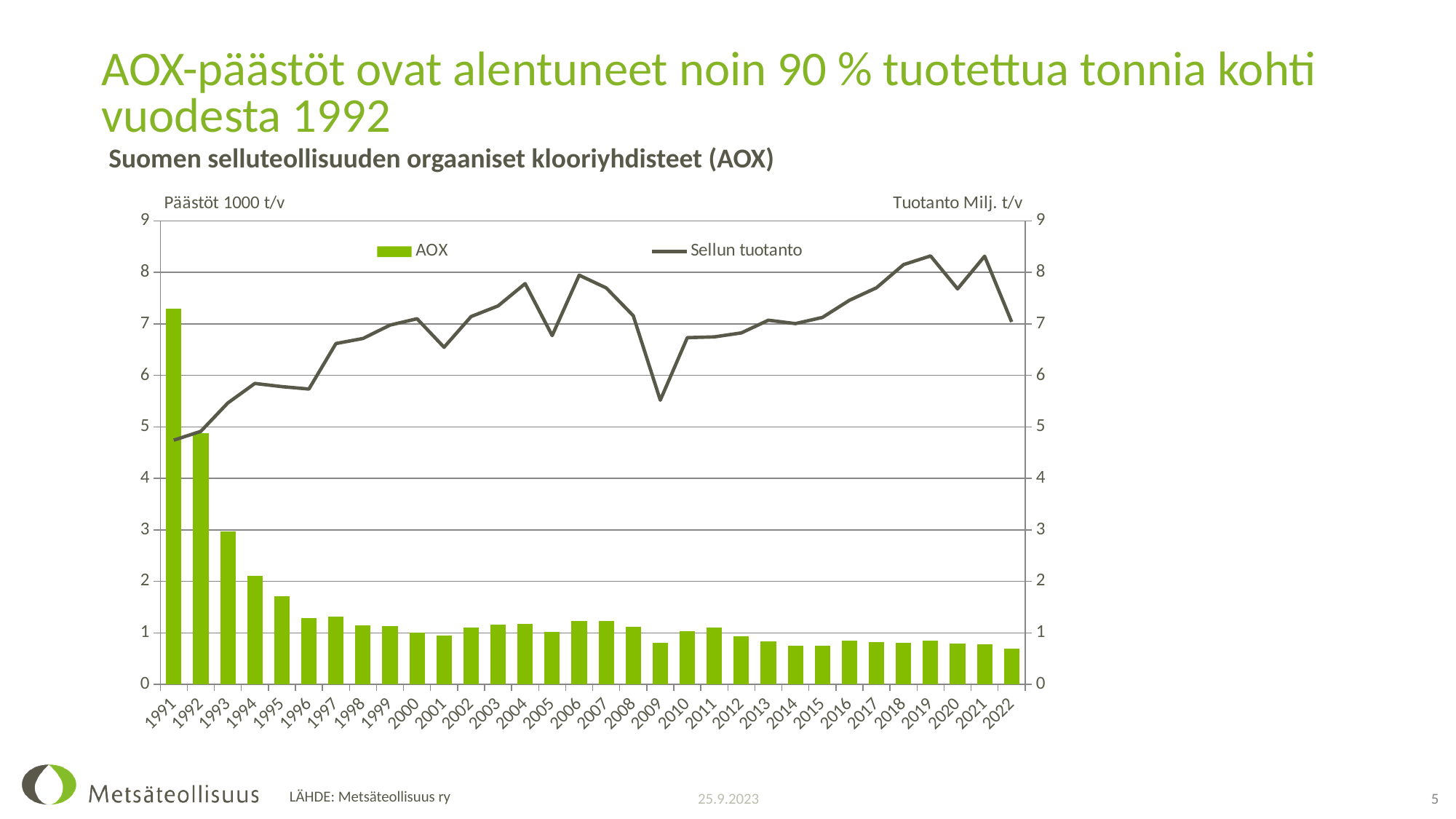
Which is larger, the AOX value for 1991 or for 1992? 1991 How many series does the legend list? 2 Which is larger, the Sellun tuotanto value for 2006 or for 2009? 2006 Is the AOX value for 1991 greater or less than 7? greater Which year has the lowest value for Sellun tuotanto? 1991 Is the Sellun tuotanto value for 2009 greater or less than 6? less What kind of chart is shown on the slide? A combined bar and line chart Which year has the highest AOX bar? 1991 Is the AOX value for 2022 greater or less than 1? less How many years are shown on the x axis? 32 What are the two series named in the legend? AOX and Sellun tuotanto Do the AOX bars generally rise or fall from 1991 to 2022? fall